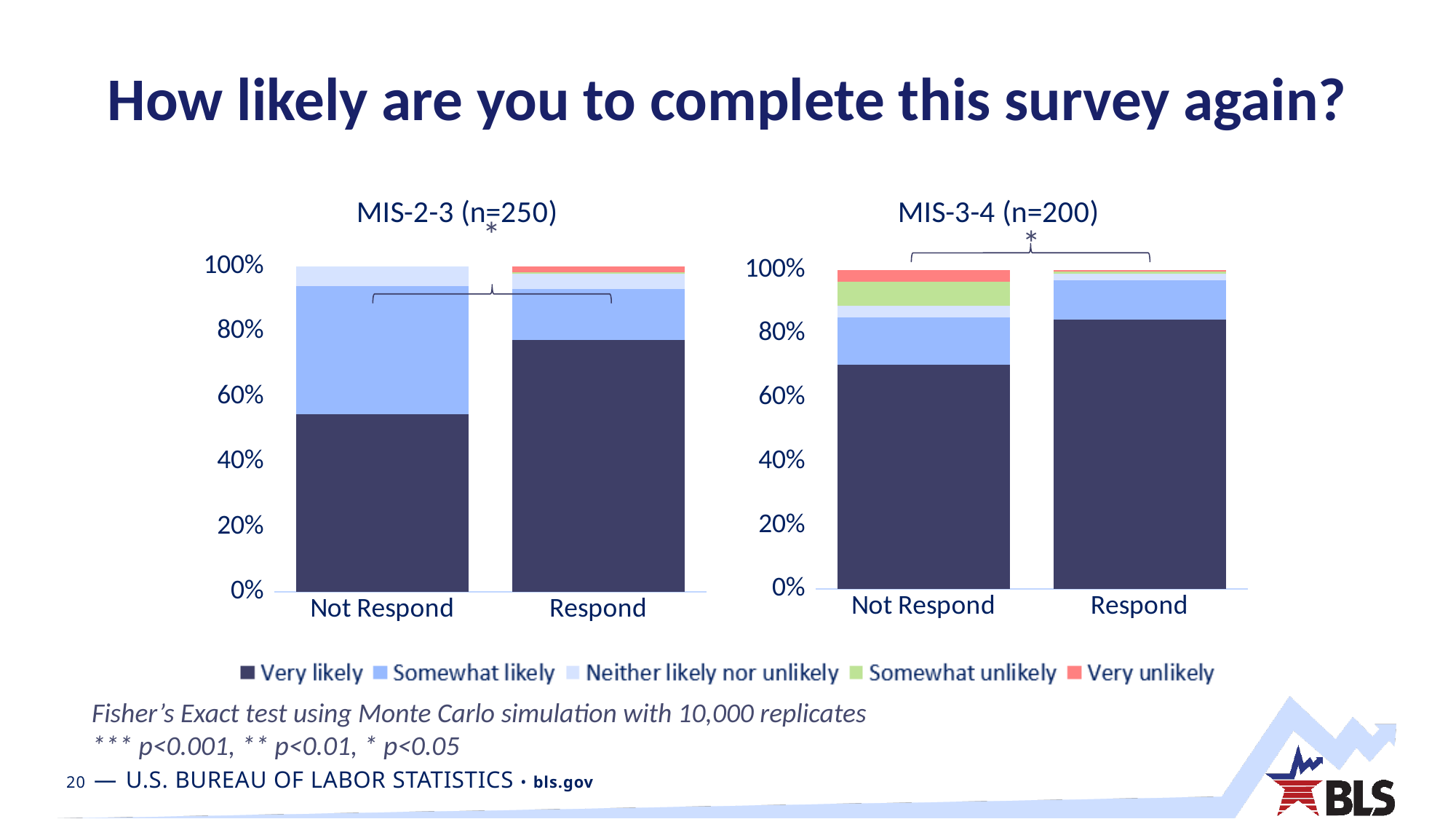
Which legend entry is shown in green? Somewhat unlikely In the MIS-3-4 (n=200) chart, is the Very likely share for Not Respond greater or less than 80%? less In the MIS-2-3 (n=250) chart, which category has the larger Very likely share, Not Respond or Respond? Respond In the MIS-2-3 (n=250) chart, is the Very likely share for Respond greater or less than 60%? greater What kind of chart is the MIS-2-3 (n=250) chart? stacked bar chart In the MIS-3-4 (n=200) chart, is the Very likely share for Respond greater or less than 80%? greater In the MIS-3-4 (n=200) chart, which category has the larger Very likely share, Not Respond or Respond? Respond How many series does the legend list? 5 What is the title of the slide? How likely are you to complete this survey again? In the MIS-3-4 (n=200) chart, how many categories are shown on the x axis? 2